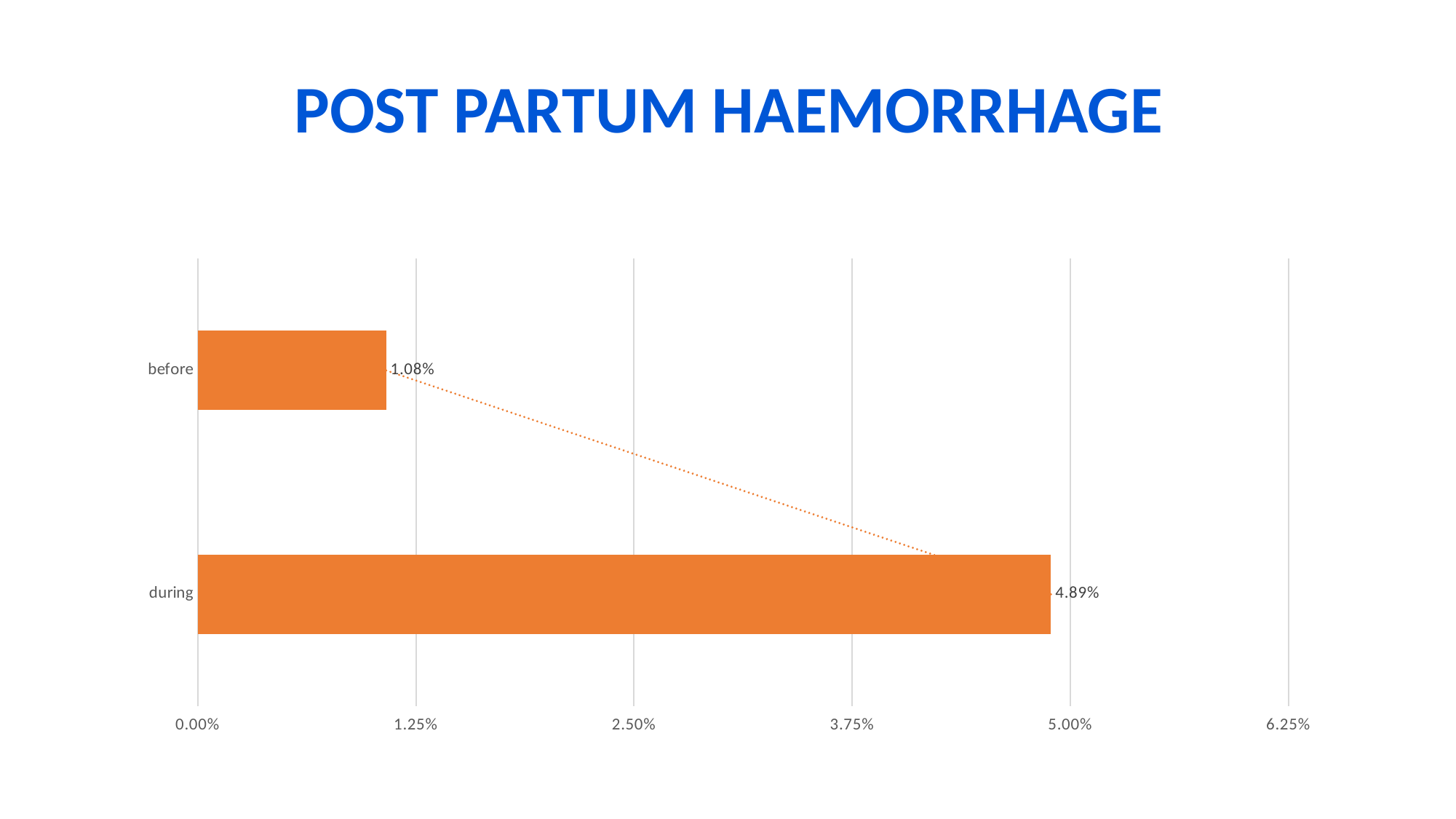
How many categories are shown on the chart? 2 What kind of chart is shown on the slide? bar chart Is the value for "during" greater or less than 3.75%? greater What is the difference between the values for "during" and "before"? 3.81% Which category has the lowest value? before What is the value for "during"? 4.89% What is the title of the slide? POST PARTUM HAEMORRHAGE Which is larger, the value for "before" or the value for "during"? during Is the value for "before" greater or less than 1.25%? less What is the value for "before"? 1.08% Which category has the highest value? during What colour are the bars in the chart? orange